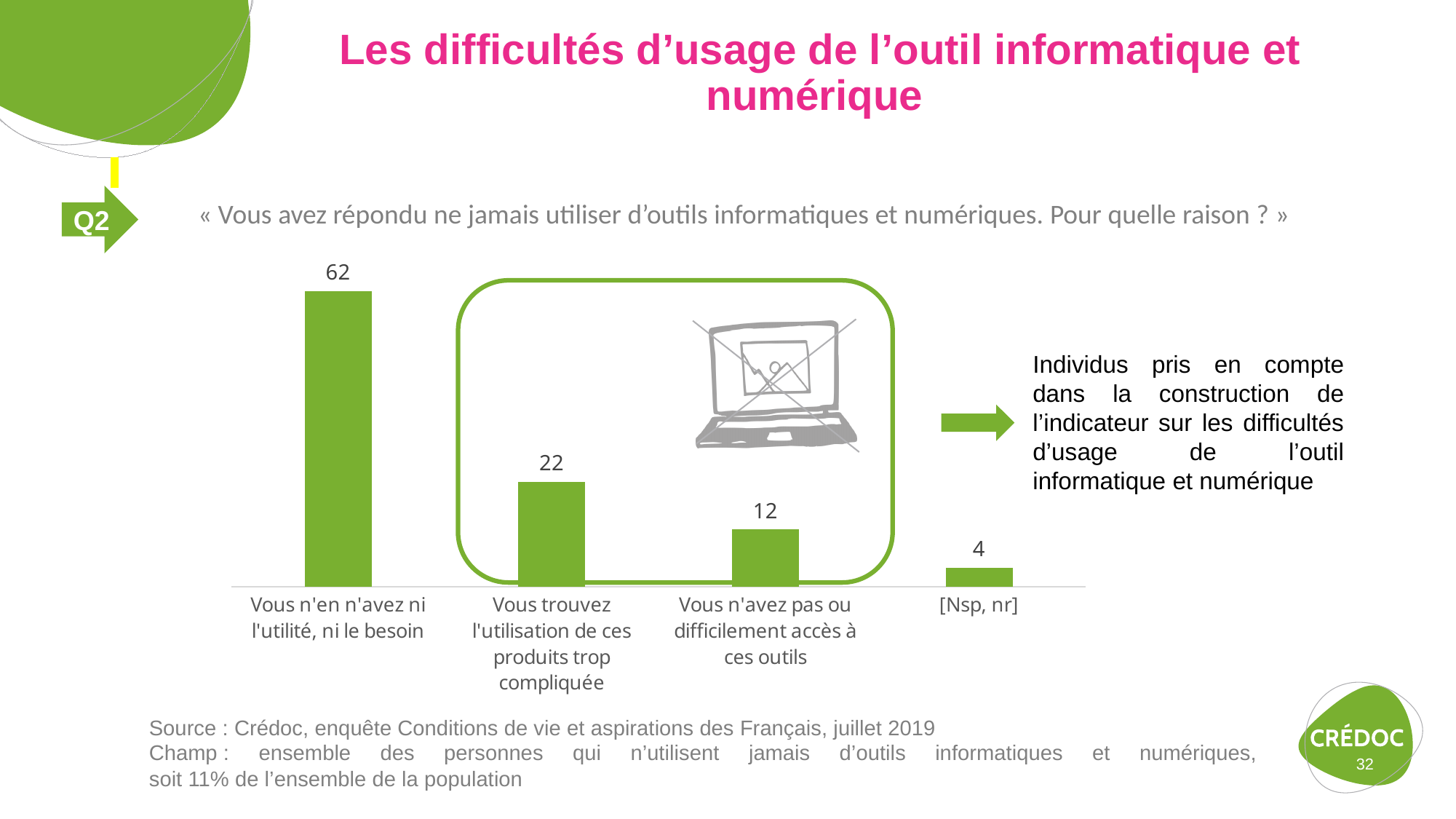
What kind of chart is shown on the slide? Bar chart Which is larger: the value for "Vous n'avez pas ou difficilement accès à ces outils" or the value for "[Nsp, nr]"? Vous n'avez pas ou difficilement accès à ces outils What is the value for "Vous n'en n'avez ni l'utilité, ni le besoin"? 62 What is the value for "Vous n'avez pas ou difficilement accès à ces outils"? 12 What is the difference between the values for "Vous n'en n'avez ni l'utilité, ni le besoin" and "Vous trouvez l'utilisation de ces produits trop compliquée"? 40 Which category has the lowest value? [Nsp, nr] What is the value for "[Nsp, nr]"? 4 Do the values rise or fall from left to right along the x axis? Fall Which category has the highest value? Vous n'en n'avez ni l'utilité, ni le besoin How many categories are shown in the chart? 4 What is the difference between the values for "Vous trouvez l'utilisation de ces produits trop compliquée" and "Vous n'avez pas ou difficilement accès à ces outils"? 10 What is the value for "Vous trouvez l'utilisation de ces produits trop compliquée"? 22